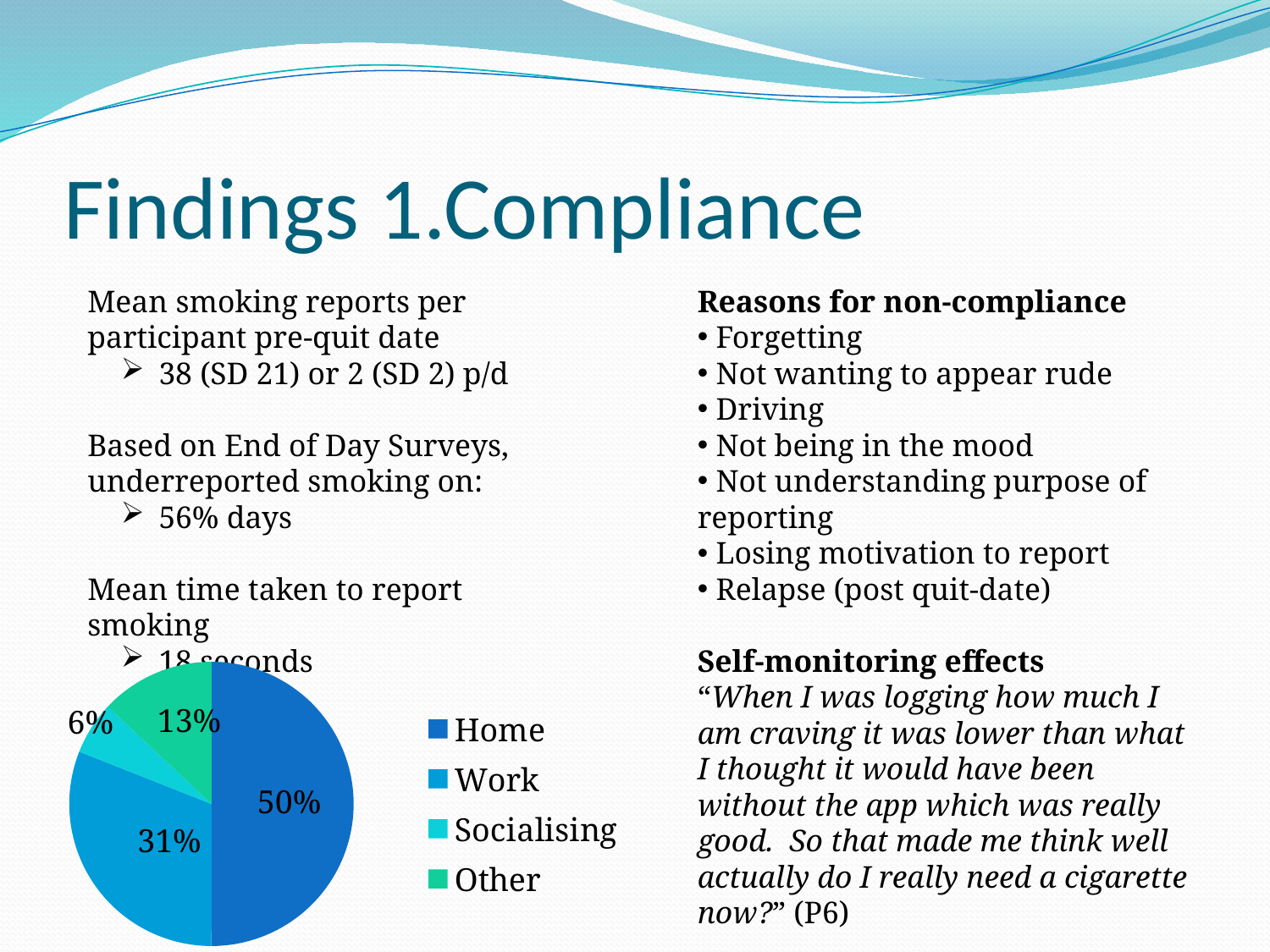
How many categories does the pie chart show? 4 Which slice is larger, Other or Socialising? Other What share of the pie chart does Work account for? 31% What is the difference in percentage points between the Home and Work slices? 19 What share of the pie chart does Other account for? 13% What kind of chart is shown on the slide? pie chart How many entries are listed in the pie chart's legend? 4 What share of the pie chart does Socialising account for? 6% What share of the pie chart does Home account for? 50% Which category has the largest slice of the pie chart? Home Which category is shown in green in the pie chart? Other Which category has the smallest slice of the pie chart? Socialising